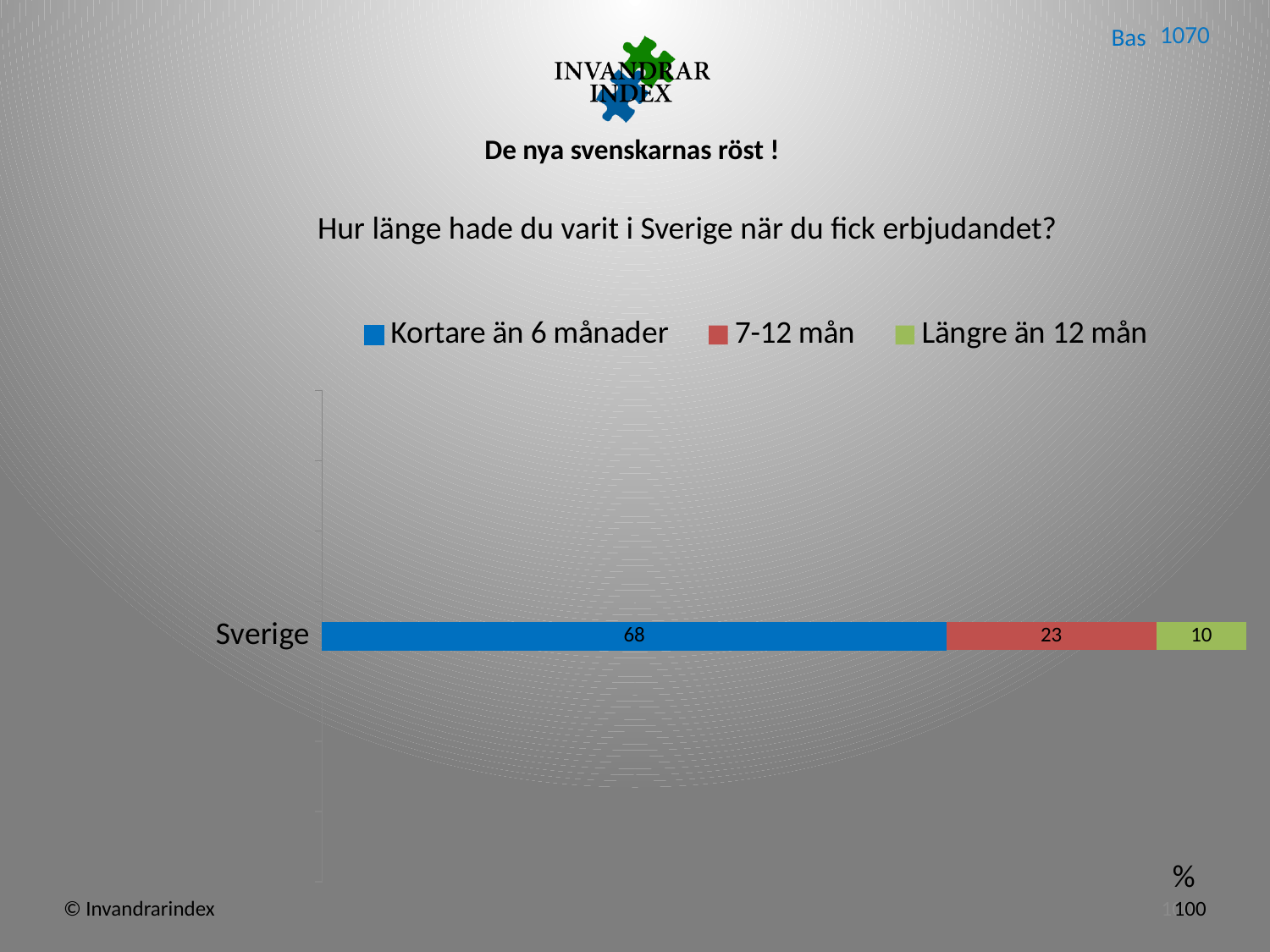
What is the value for 'Längre än 12 mån' for Sverige? 10 What is the value for 'Kortare än 6 månader' for Sverige? 68 How many categories are shown on the chart? 1 How many series does the legend list? 3 What is the difference between the '7-12 mån' and 'Längre än 12 mån' values for Sverige? 13 Which series has the highest value for Sverige? Kortare än 6 månader What is the value for '7-12 mån' for Sverige? 23 What is the total of the stacked bar for Sverige? 101 What kind of chart is shown on the slide? Stacked bar chart Which is larger for Sverige: '7-12 mån' or 'Längre än 12 mån'? 7-12 mån What is the difference between the 'Kortare än 6 månader' and '7-12 mån' values for Sverige? 45 Which series has the lowest value for Sverige? Längre än 12 mån